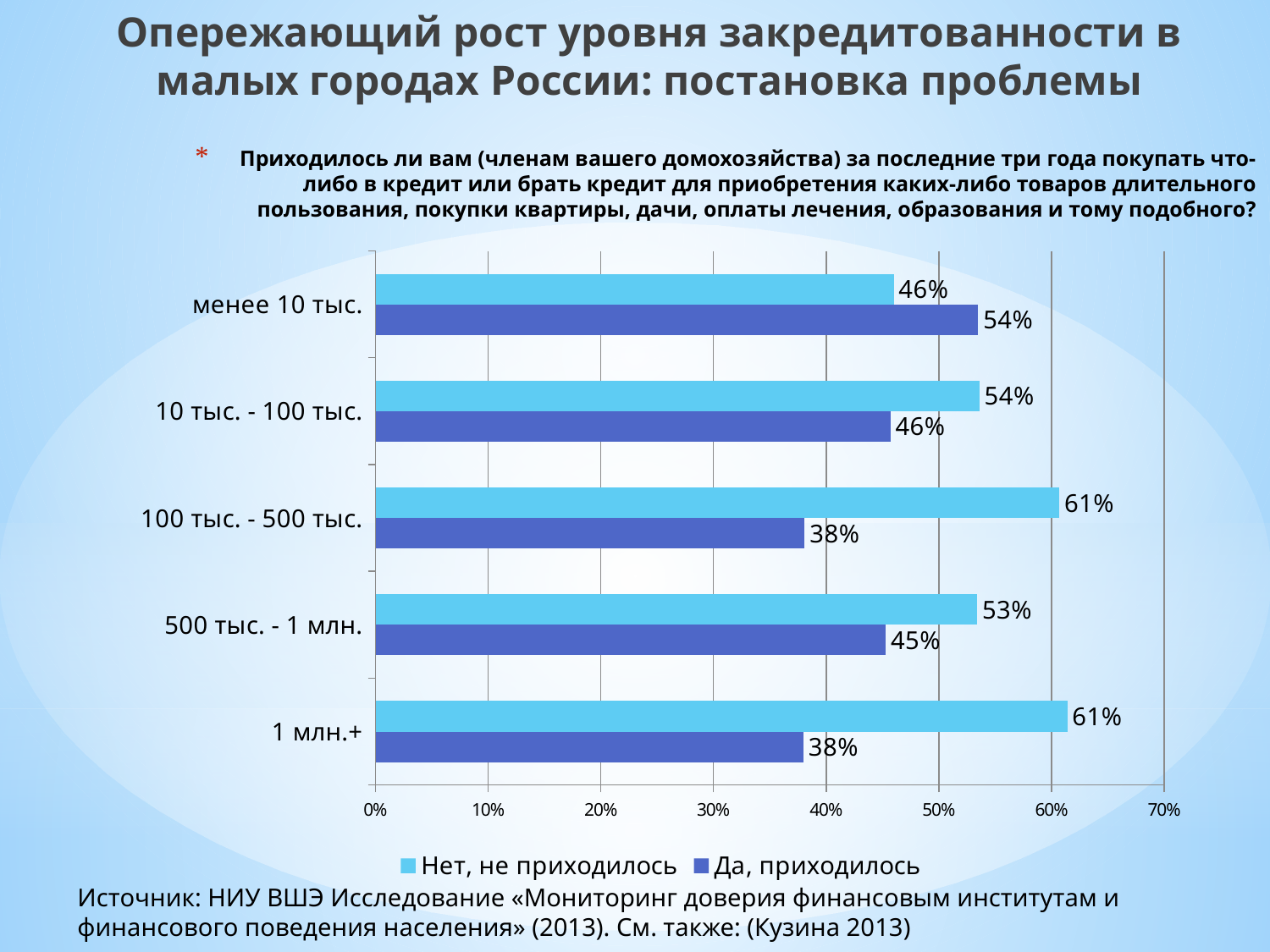
What kind of chart is shown on the slide? bar chart What is the value of "Да, приходилось" for "менее 10 тыс."? 54% What is the value of "Нет, не приходилось" for "1 млн.+"? 61% Which category has the highest value for "Да, приходилось"? менее 10 тыс. How many series does the legend list? 2 Which legend entry is shown in the darker blue colour? Да, приходилось For "10 тыс. - 100 тыс.", which is larger: "Нет, не приходилось" or "Да, приходилось"? Нет, не приходилось What is the value of "Да, приходилось" for "500 тыс. - 1 млн."? 45% Which category has the lowest value for "Нет, не приходилось"? менее 10 тыс. How many city-size categories are shown on the chart? 5 What is the value of "Нет, не приходилось" for "100 тыс. - 500 тыс."? 61% What is the difference between "Нет, не приходилось" and "Да, приходилось" for "100 тыс. - 500 тыс."? 23%